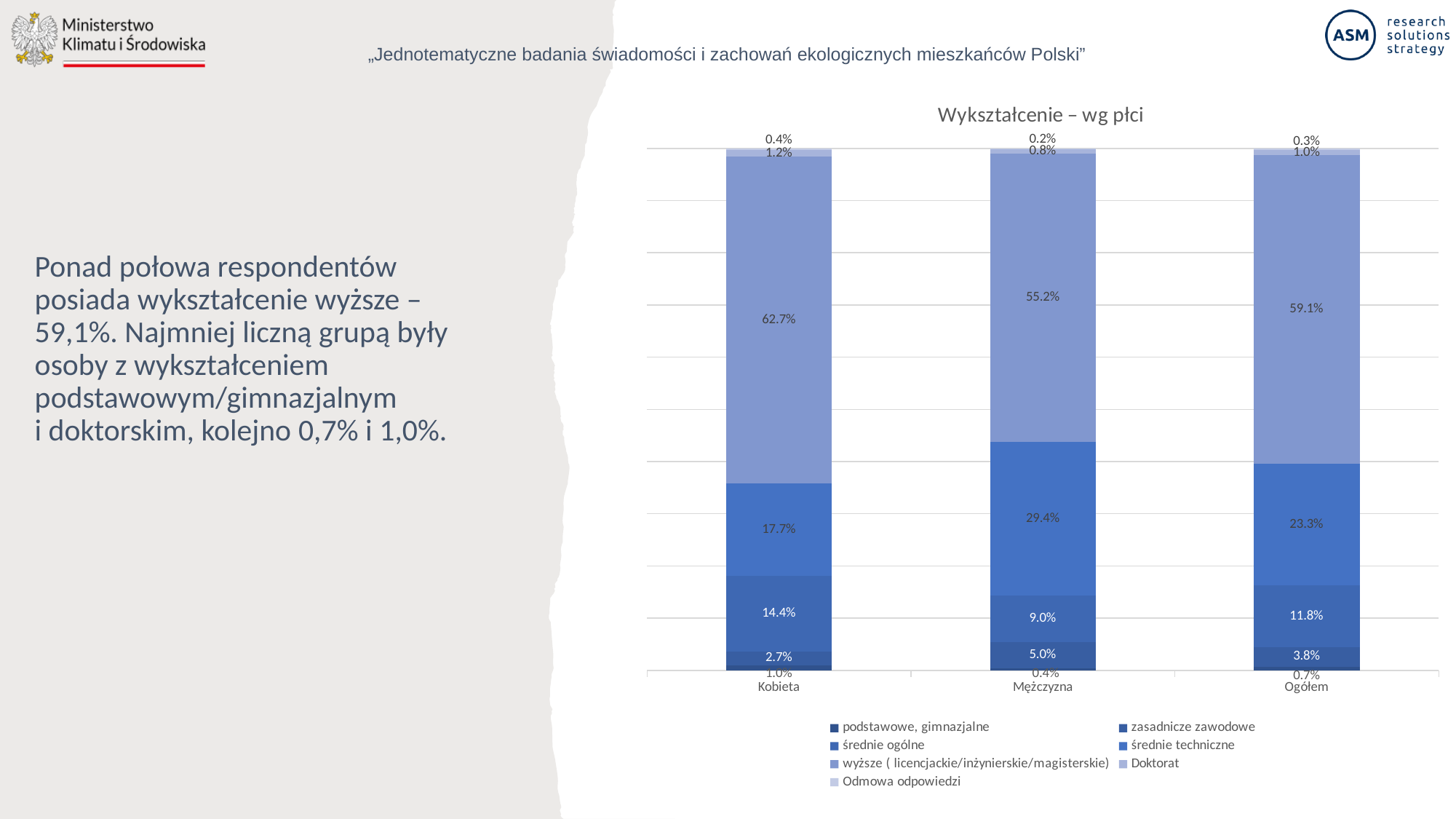
Which category has the highest value for 'wyższe ( licencjackie/inżynierskie/magisterskie)'? Kobieta What is the value of 'Doktorat' for Ogółem? 1.0% What is the difference between the 'średnie techniczne' values for Mężczyzna and Kobieta? 11.7% How many categories are shown on the x axis of the chart? 3 What kind of chart is shown on the slide? stacked bar chart Which category has the lowest value for 'średnie ogólne'? Mężczyzna What is the value of 'wyższe ( licencjackie/inżynierskie/magisterskie)' for Kobieta? 62.7% Which is larger: 'zasadnicze zawodowe' for Mężczyzna or for Kobieta? Mężczyzna What is the value of 'średnie ogólne' for Ogółem? 11.8% What is the value of 'średnie techniczne' for Mężczyzna? 29.4% What is the title of the chart? Wykształcenie – wg płci How many series does the chart's legend list? 7